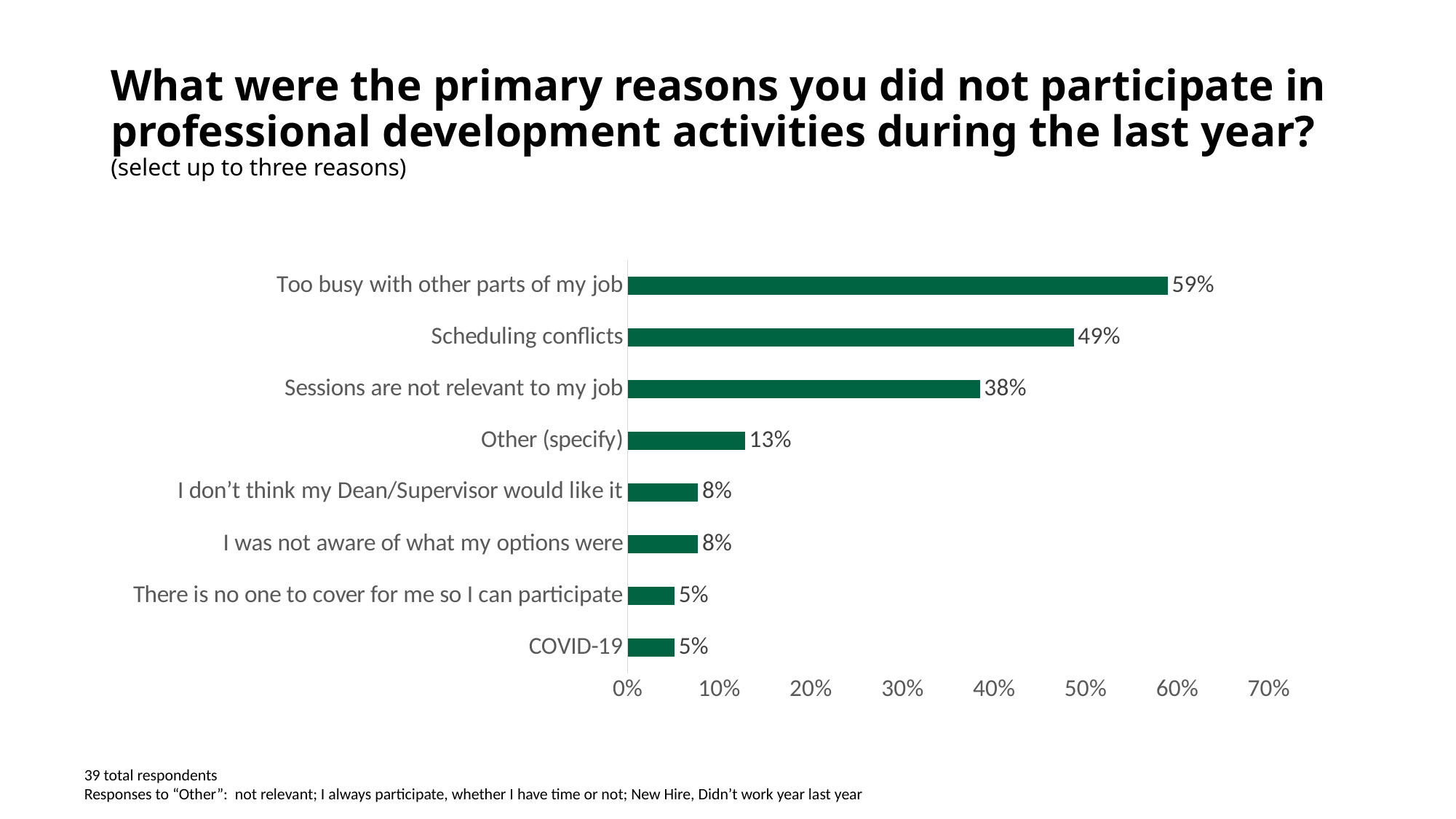
How many total respondents are noted on the slide? 39 What is the value for "Other (specify)"? 13% What kind of chart is shown on the slide? Bar chart Is the value for "Sessions are not relevant to my job" greater or less than 40%? less What percentage selected "Sessions are not relevant to my job"? 38% Which is larger: "Other (specify)" or "I was not aware of what my options were"? Other (specify) What is the difference between "Scheduling conflicts" and "Sessions are not relevant to my job"? 11% What is the value for "Scheduling conflicts"? 49% How many reasons (categories) are shown in the chart? 8 Which reason has the highest percentage? Too busy with other parts of my job What percentage of respondents selected "Too busy with other parts of my job"? 59% What is the difference between "Too busy with other parts of my job" and "Scheduling conflicts"? 10%